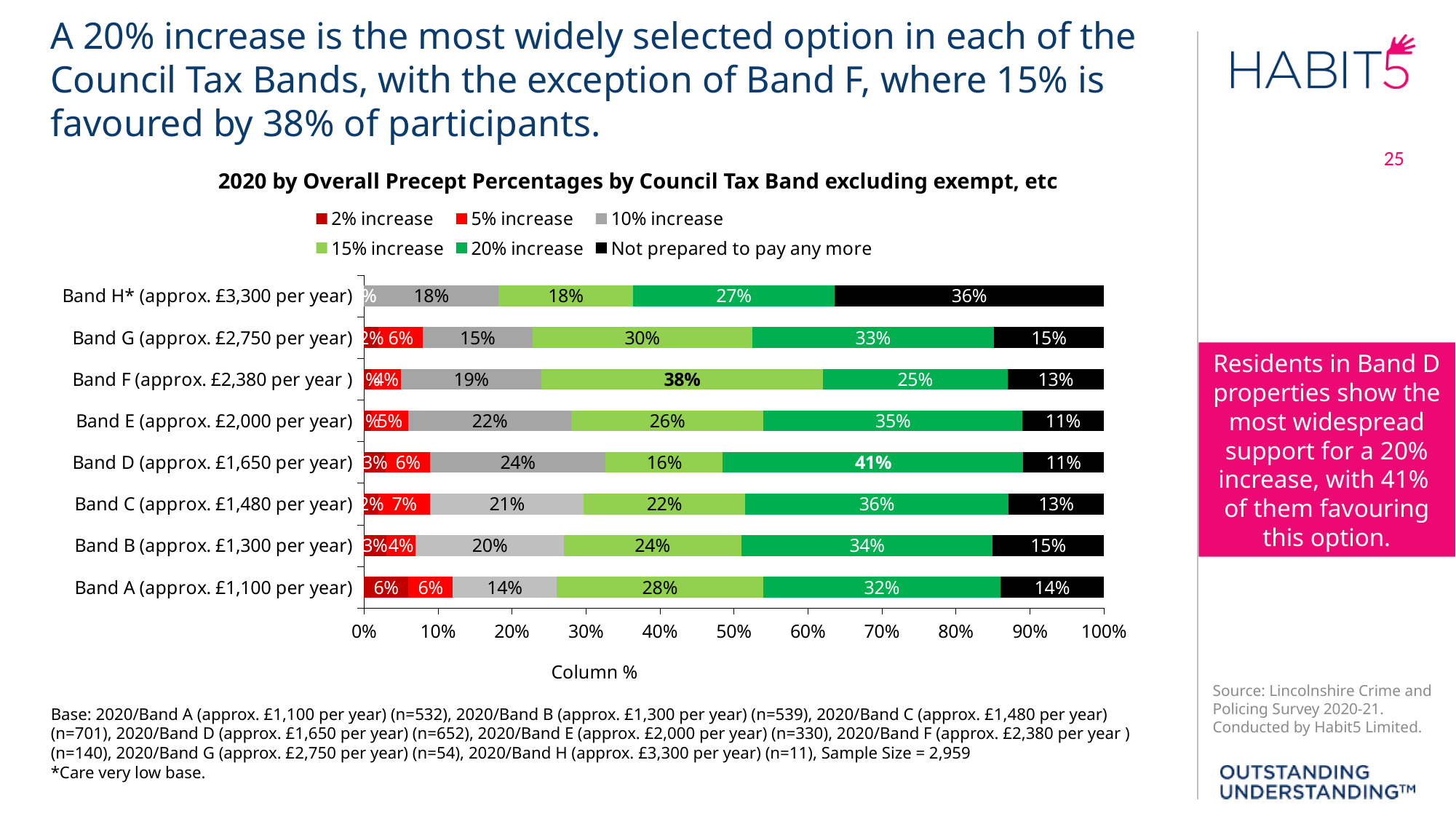
What is the title of the chart? 2020 by Overall Precept Percentages by Council Tax Band excluding exempt, etc What percentage of Band H* (approx. £3,300 per year) participants are not prepared to pay any more? 36% What percentage of Band A (approx. £1,100 per year) participants favour a 10% increase? 14% What kind of chart is shown on the slide? Stacked bar chart How many Council Tax Bands are shown on the chart? 8 What percentage of Band F (approx. £2,380 per year) participants favour a 15% increase? 38% What is the difference between the 20% increase share for Band D (approx. £1,650 per year) and Band A (approx. £1,100 per year)? 9 percentage points What percentage of Band D (approx. £1,650 per year) participants favour a 20% increase? 41% Which Council Tax Band has the highest share of participants not prepared to pay any more? Band H* (approx. £3,300 per year) How many series does the legend list? 6 Which Council Tax Band has the lowest share of participants favouring a 20% increase? Band H* (approx. £3,300 per year) Which is larger: the 15% increase share for Band G (approx. £2,750 per year) or for Band E (approx. £2,000 per year)? Band G (approx. £2,750 per year)